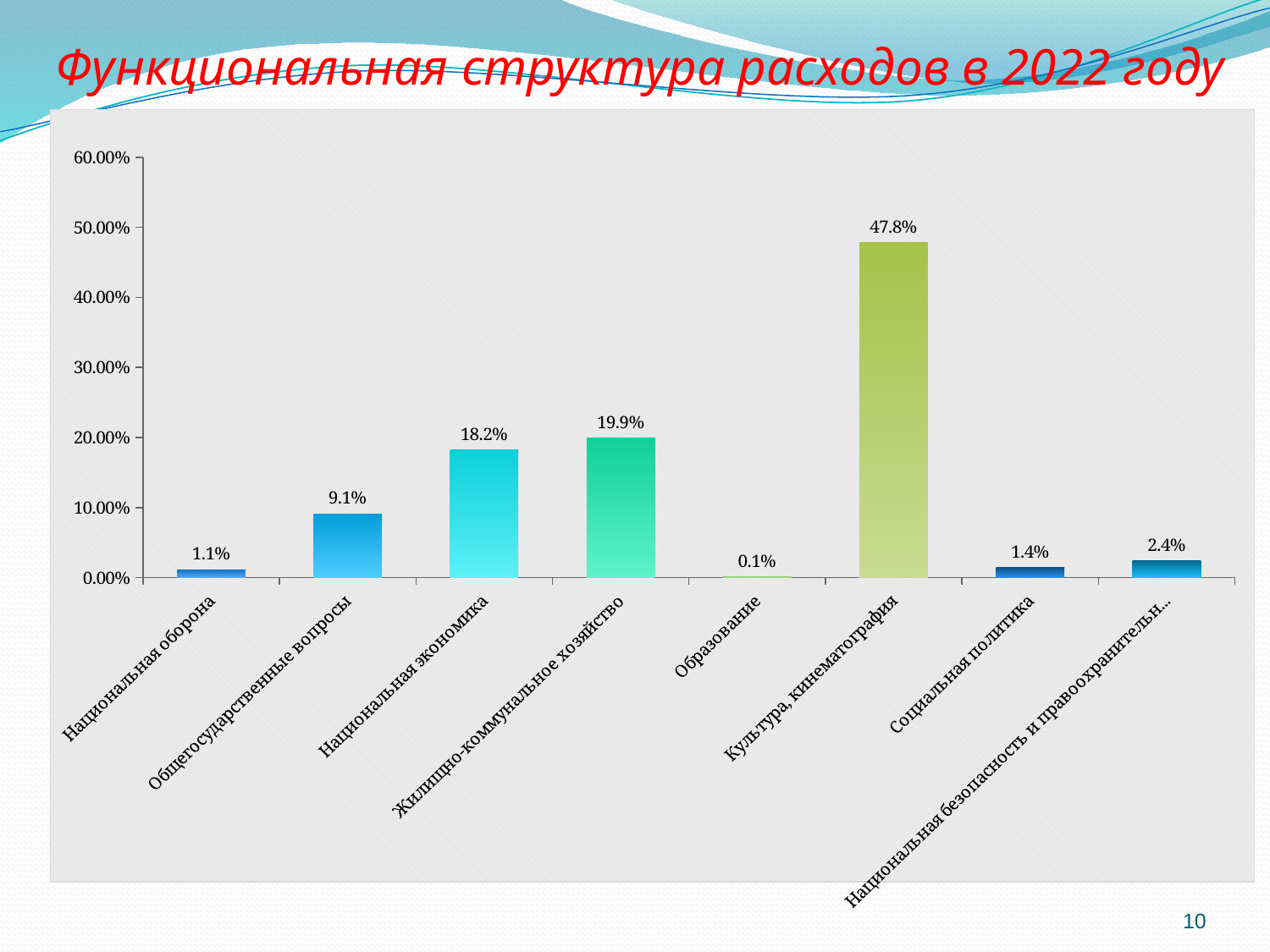
What is the title of the slide? Функциональная структура расходов в 2022 году What kind of chart is shown on the slide? bar chart What is the value for Жилищно-коммунальное хозяйство? 19.9% Which category has the highest value? Культура, кинематография Is the value for Культура, кинематография greater or less than 40.00%? greater What is the value for Социальная политика? 1.4% What is the value for Национальная оборона? 1.1% Which category has the lowest value? Образование How many categories are shown on the x axis? 8 What is the value for Культура, кинематография? 47.8% Which is larger, the value for Общегосударственные вопросы or the value for Национальная экономика? Национальная экономика What is the difference between the values for Жилищно-коммунальное хозяйство and Национальная экономика? 1.7%